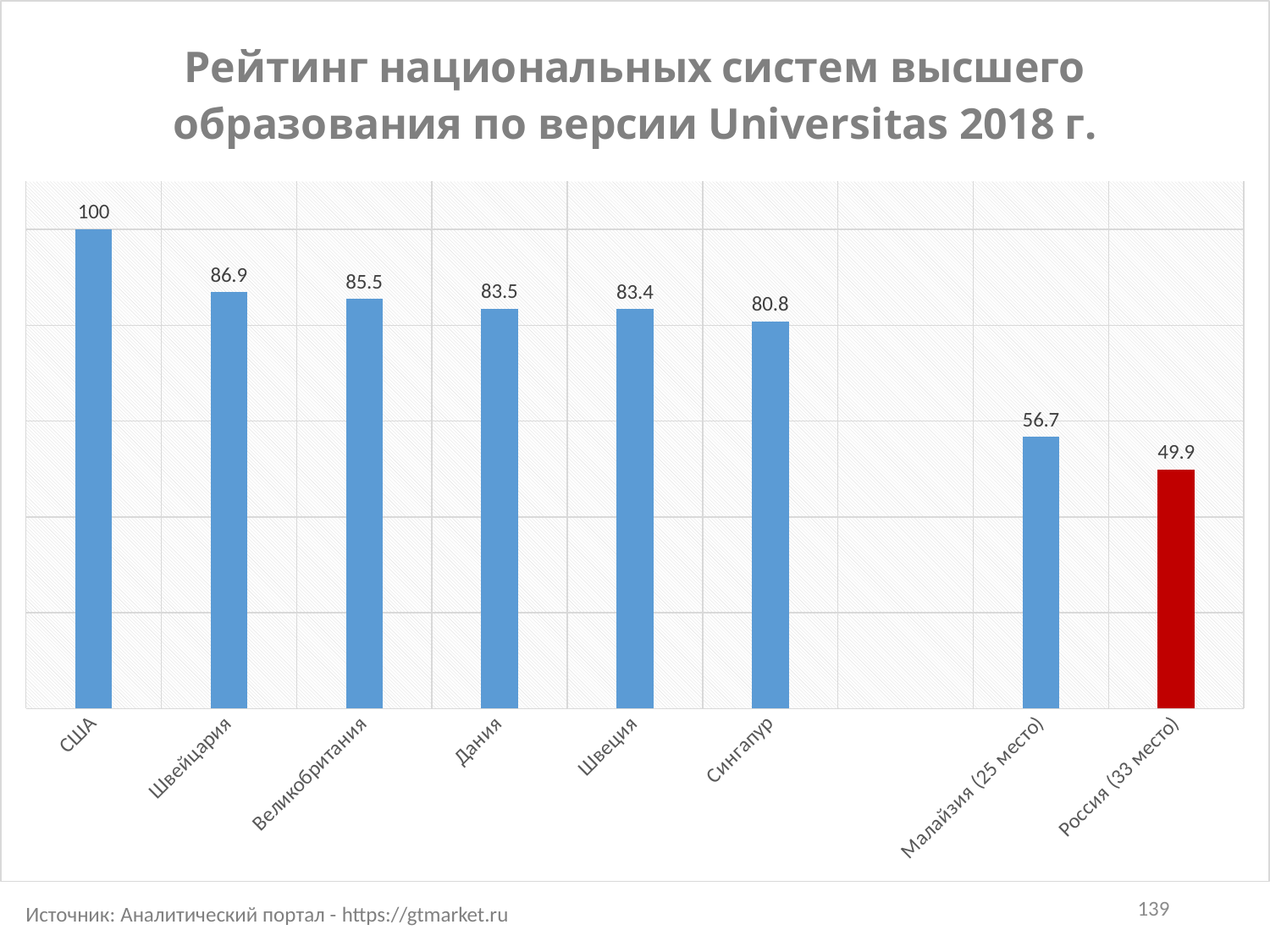
What is the value for Швейцария? 86.9 Which has a larger value, Сингапур or Малайзия (25 место)? Сингапур What is the value for Россия (33 место)? 49.9 Which country has the lowest value? Россия (33 место) Which country has the highest value? США What is the difference between the values for США and Россия (33 место)? 50.1 What type of chart is shown on the slide? Bar chart How many countries are shown in the chart? 8 What is the value for США? 100 What is the value for Малайзия (25 место)? 56.7 What is the difference between the values for Малайзия (25 место) and Россия (33 место)? 6.8 Do the values rise or fall from left to right along the x axis? Fall